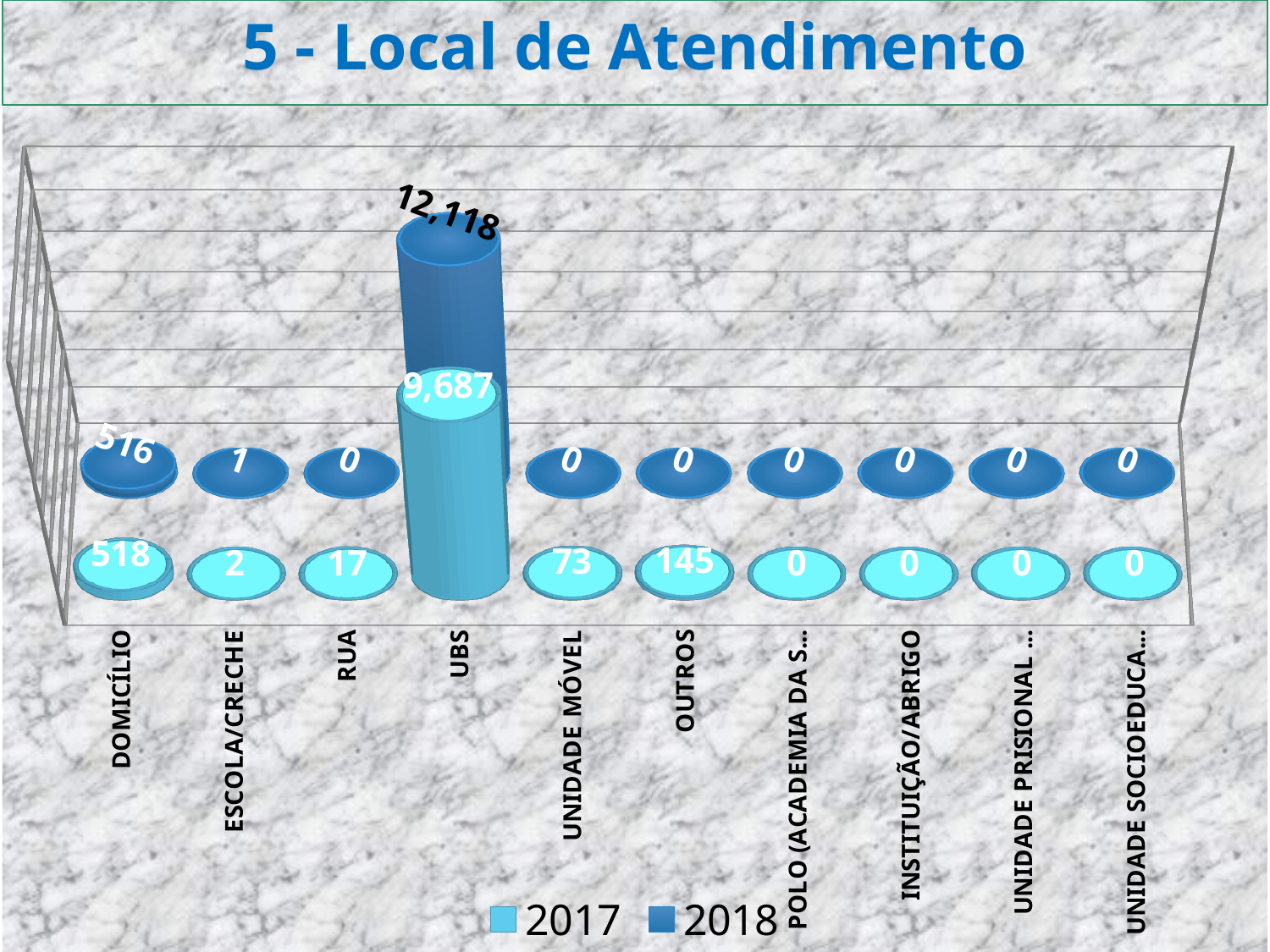
What is the difference between the 2017 values for OUTROS and UNIDADE MÓVEL? 72 What is the 2017 value for UNIDADE MÓVEL? 73 What is the 2017 value for OUTROS? 145 What is the 2018 value for UBS? 12,118 How many series does the legend list? 2 How many categories are shown on the x axis? 10 What is the 2018 value for DOMICÍLIO? 516 What is the difference between the 2018 and 2017 values for UBS? 2,431 Which is larger for RUA, the 2017 value or the 2018 value? 2017 What is the 2017 value for UBS? 9,687 What kind of chart is shown on the slide? Bar chart Which category has the highest 2017 value? UBS